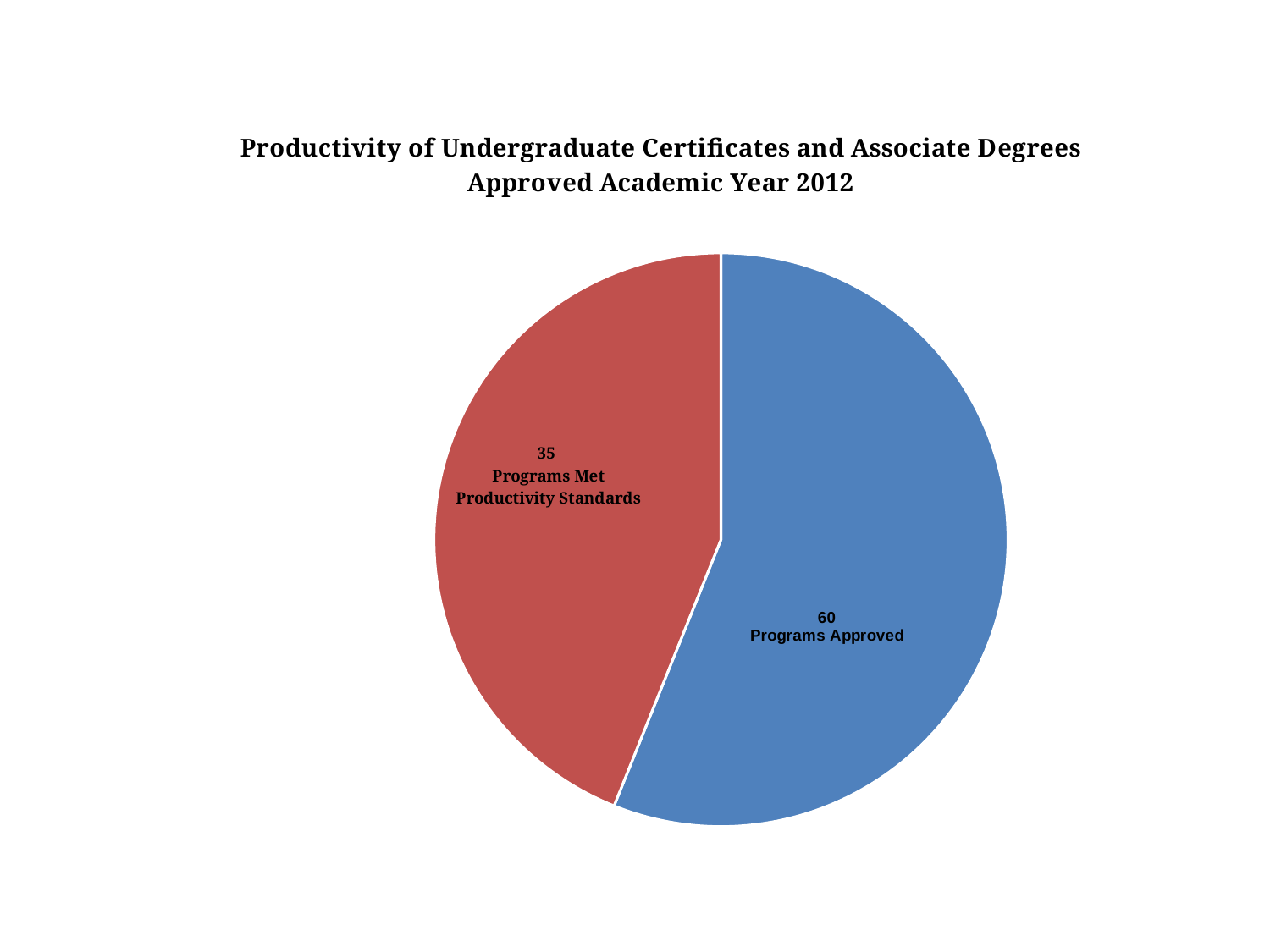
How many slices does the pie chart have? 2 Which is larger, Programs Approved or Programs Met Productivity Standards? Programs Approved Which slice is the smallest? Programs Met Productivity Standards What is the title of the chart? Productivity of Undergraduate Certificates and Associate Degrees Approved Academic Year 2012 What type of chart is shown on the slide? Pie chart What is the value for Programs Approved? 60 Which slice is the largest? Programs Approved What is the value for Programs Met Productivity Standards? 35 What is the total of the two slices in the pie chart? 95 What is the difference between Programs Approved and Programs Met Productivity Standards? 25 What colour is the Programs Met Productivity Standards slice? Red